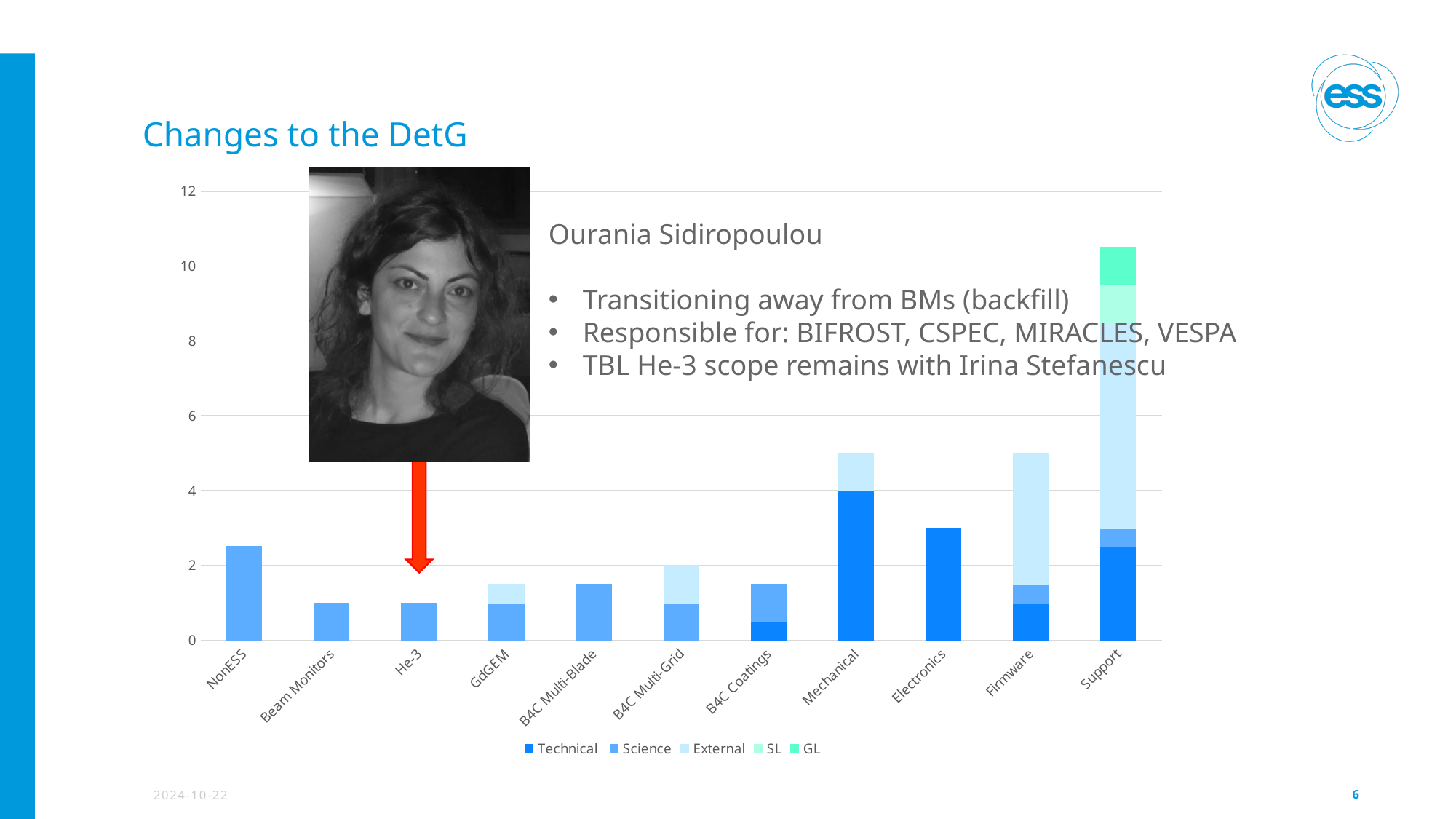
Which has the larger total, Support or Mechanical? Support Which category has the tallest stacked bar? Support Is the total value for NonESS greater or less than 2? greater Which series in the legend is shown in green? GL Is the total value for Support greater or less than 10? greater How many categories are shown along the x axis of the chart? 11 What is the total height of the stacked bar for B4C Multi-Grid? 2 Which has the larger total, Firmware or Electronics? Firmware How many series does the chart legend list? 5 What kind of chart is shown on the slide? stacked bar chart Is the total value for Mechanical greater or less than 4? greater